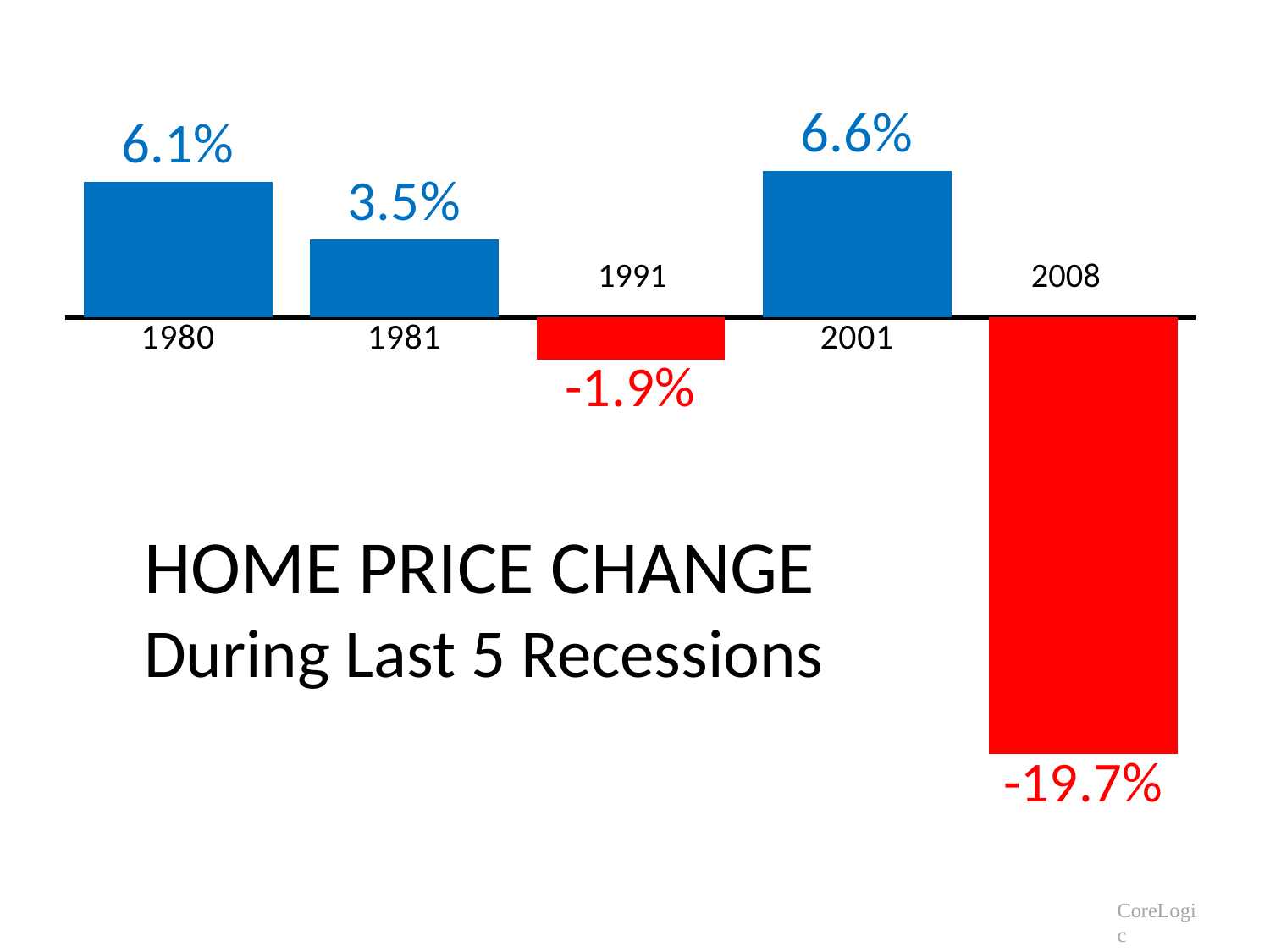
What is the title of the chart? HOME PRICE CHANGE During Last 5 Recessions What was the home price change during the 1980 recession? 6.1% What type of chart is shown on the slide? Bar chart What was the home price change during the 2008 recession? -19.7% What colour are the bars for recessions with negative home price changes? Red What was the home price change during the 1991 recession? -1.9% What is the difference between the home price change in 2001 and in 1981? 3.1% How many recessions are shown in the chart? 5 Which recession had a larger home price change, 1980 or 1981? 1980 Which recession year shows the highest home price change? 2001 How many recessions show a negative home price change? 2 Which recession year shows the lowest home price change? 2008